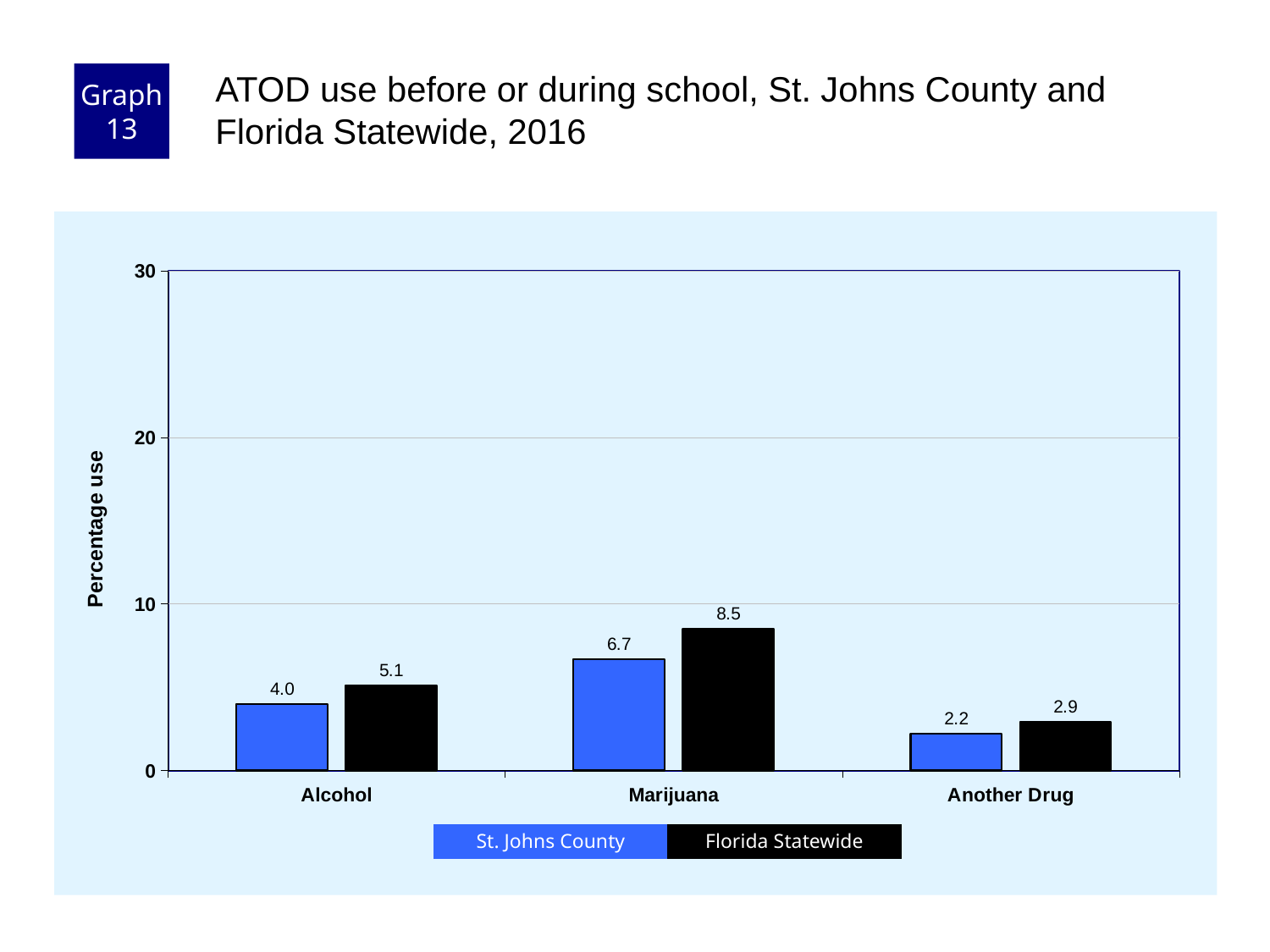
Which category has the highest Florida Statewide value? Marijuana How many categories are shown on the x axis? 3 What is the St. Johns County value for Alcohol? 4.0 What is the St. Johns County value for Another Drug? 2.2 What kind of chart is shown on the slide? bar chart What is the difference between the Florida Statewide and St. Johns County values for Marijuana? 1.8 How many series does the legend list? 2 Is the Florida Statewide value for Marijuana greater or less than 10? less Which category has the lowest St. Johns County value? Another Drug What is the difference between the Florida Statewide and St. Johns County values for Alcohol? 1.1 Which is larger for Another Drug, St. Johns County or Florida Statewide? Florida Statewide What is the Florida Statewide value for Marijuana? 8.5